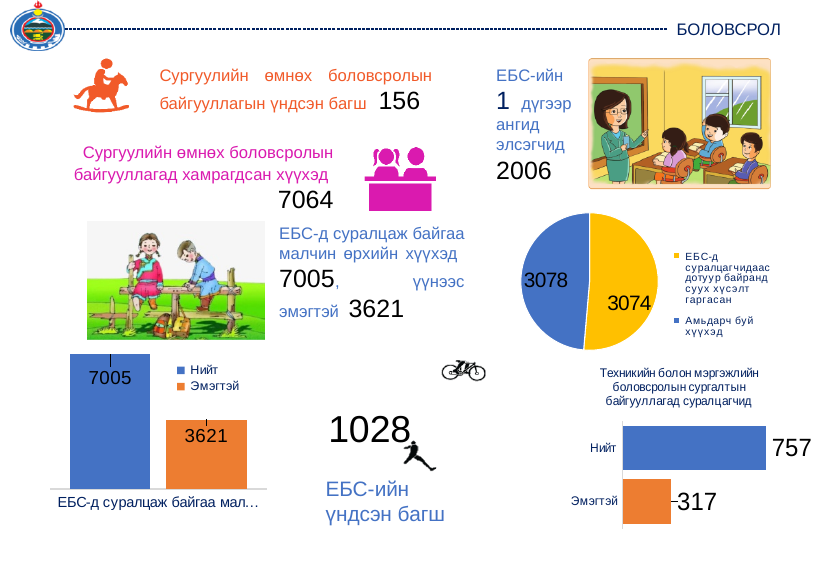
In the bottom-left bar chart, which is larger, Нийт or Эмэгтэй? Нийт In the chart titled 'Техникийн болон мэргэжлийн боловсролын сургалтын байгууллагад суралцагчид', what is the difference between Нийт and Эмэгтэй? 440 In the pie chart on the right, what is the difference between the two slices? 4 In the bottom-left bar chart, what is the value for Нийт? 7005 What kind of chart is the bottom-left chart with the values 7005 and 3621? Bar chart In the chart titled 'Техникийн болон мэргэжлийн боловсролын сургалтын байгууллагад суралцагчид', what is the value for Эмэгтэй? 317 In the pie chart on the right, what is the value of the yellow slice (ЕБС-д суралцагчидаас дотуур байранд суух хүсэлт гаргасан)? 3074 In the bottom-left bar chart, what is the difference between Нийт and Эмэгтэй? 3384 In the pie chart on the right, what is the value of the blue slice (Амьдарч буй хүүхэд)? 3078 How many series does the legend of the bottom-left bar chart list? 2 In the bottom-left bar chart, what is the value for Эмэгтэй? 3621 In the chart titled 'Техникийн болон мэргэжлийн боловсролын сургалтын байгууллагад суралцагчид', what is the value for Нийт? 757